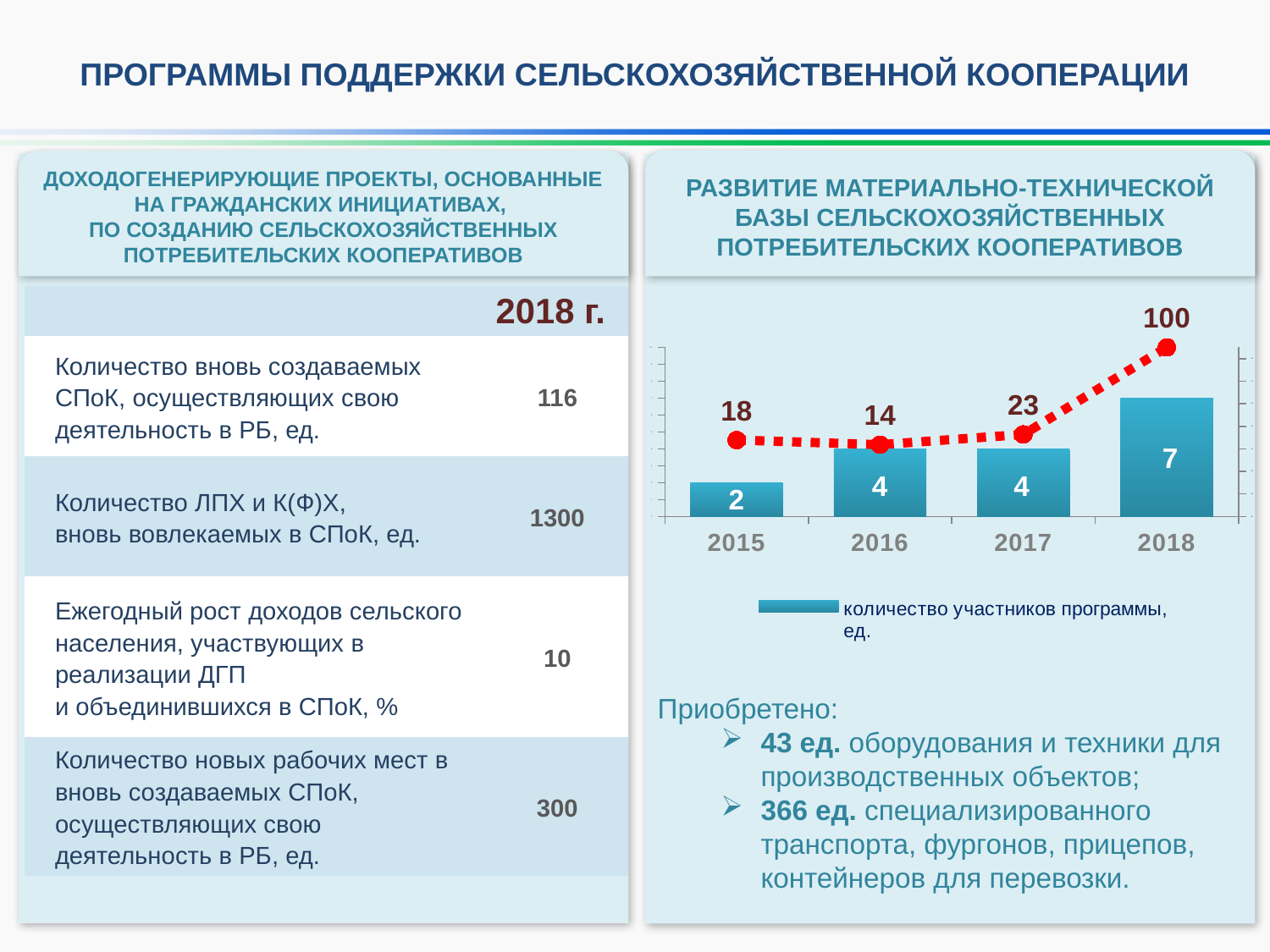
What kind of chart is shown on the right side of the slide? A combined bar and line chart Which is larger, the red dotted line value for 2015 or for 2016? 2015 What is the number of program participants (bar) for 2015? 2 What does the legend entry below the chart say the bars represent? количество участников программы, ед. What is the difference between the red dotted line values for 2018 and 2017? 77 What is the difference in program participants (bars) between 2018 and 2015? 5 Which year has the lowest value on the red dotted line? 2016 Which year has the highest number of program participants (bars)? 2018 How many years are shown on the x axis of the chart? 4 What value does the red dotted line show for 2018? 100 What is the number of program participants (bar) for 2018? 7 What value does the red dotted line show for 2017? 23